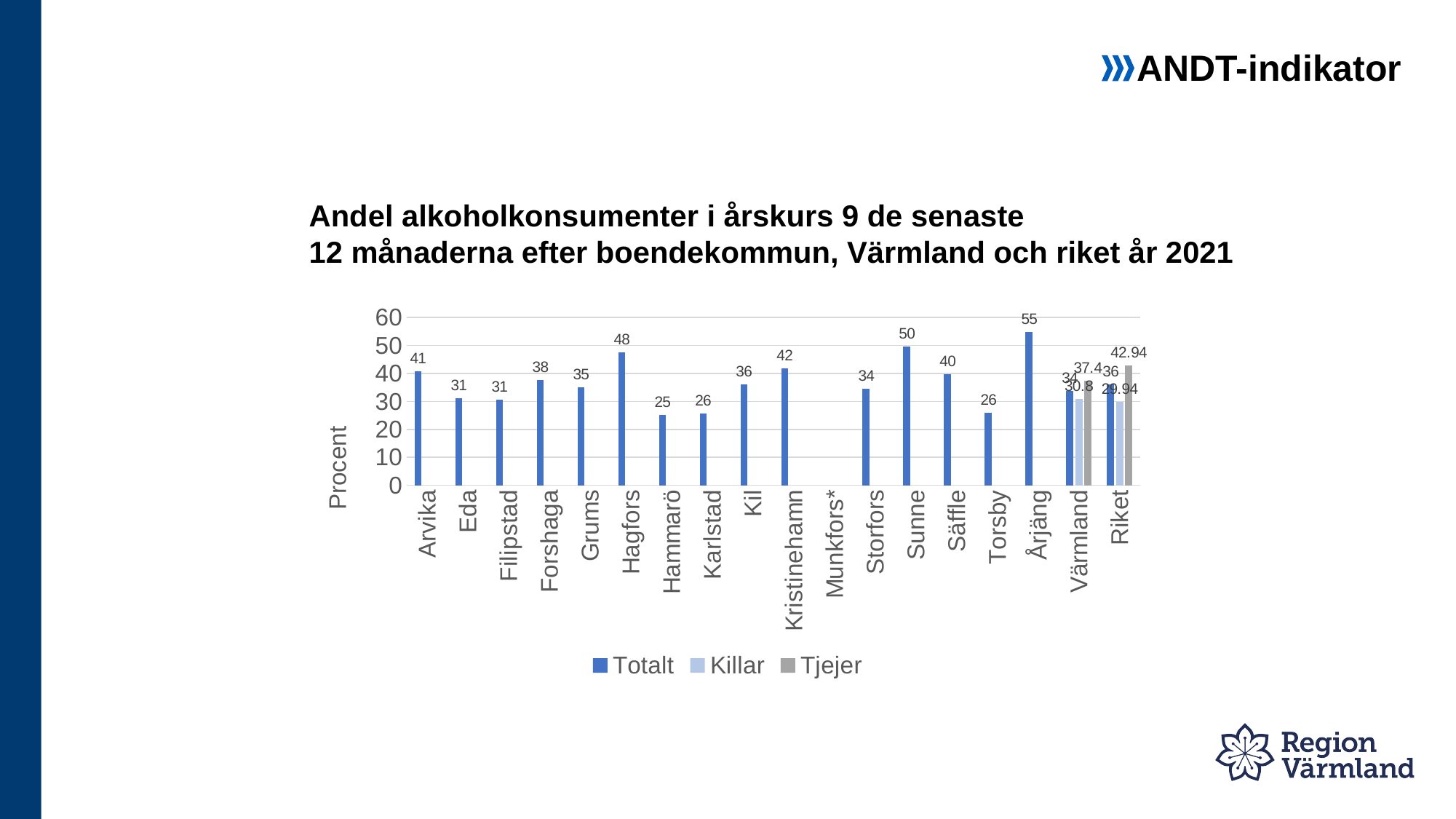
What kind of chart is shown on the slide? Bar chart Is the Totalt value for Sunne greater or less than 40? greater What is the Killar value for Värmland? 30.8 How many categories are shown on the x axis? 18 What is the Tjejer value for Riket? 42.94 What is the Totalt value for Hagfors? 48 Which has a higher Totalt value, Kristinehamn or Kil? Kristinehamn What is the label on the y axis? Procent Which municipality has the highest Totalt value? Årjäng Which municipality has the lowest Totalt value? Hammarö What is the difference between the Totalt values for Årjäng and Hammarö? 30 How many series does the legend list? 3